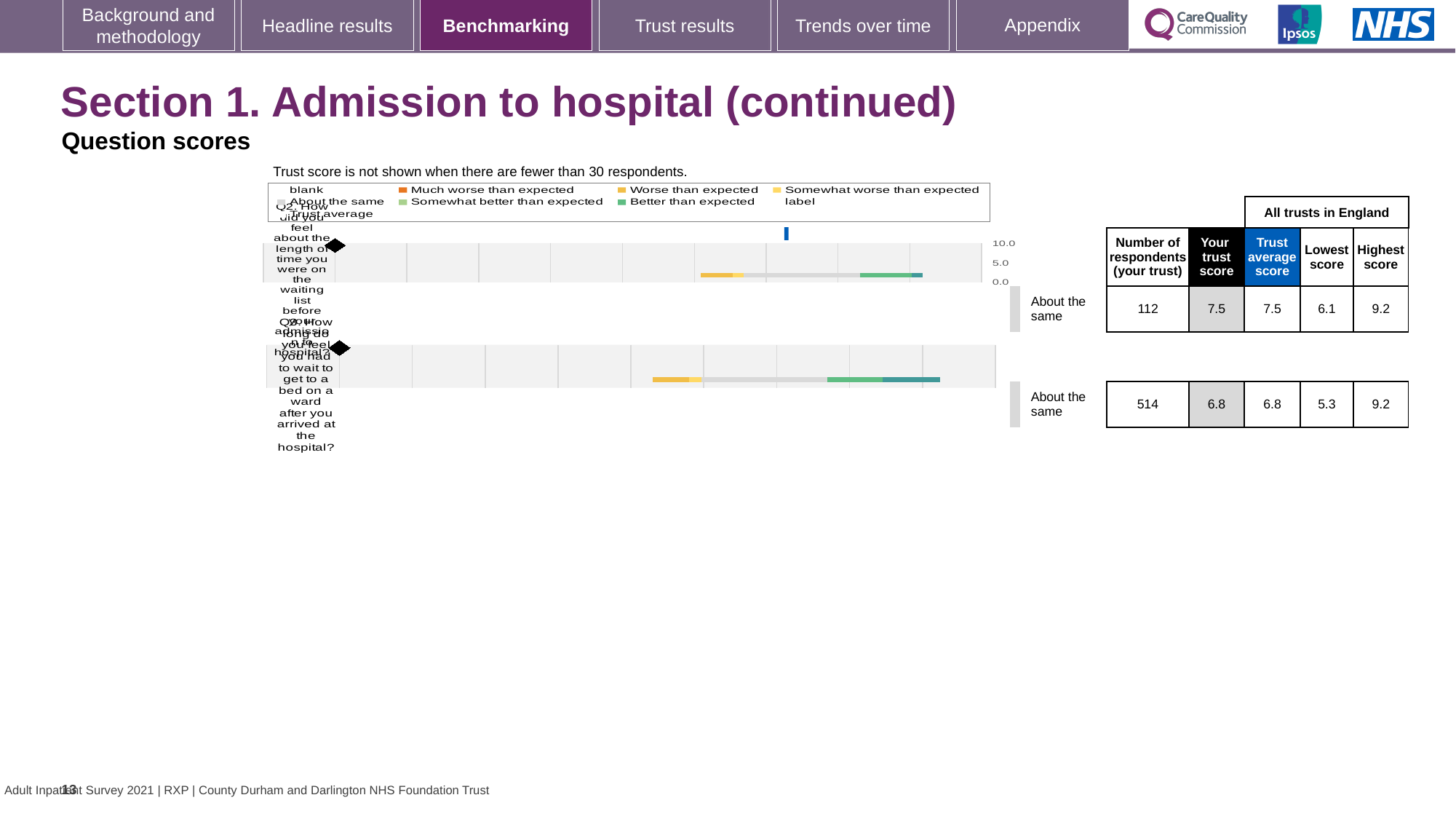
How many respondents answered Q2 for this trust? 112 What is the lowest score across all trusts in England for Q2? 6.1 What kind of chart is used to show the question scores on this slide? bar chart What is the difference between the highest and lowest scores for Q3? 3.9 What is the highest score across all trusts in England for Q3? 9.2 How many respondents answered Q3 for this trust? 514 What benchmark category is shown for Q2? About the same What is the trust score for Q3 (wait to get to a bed on a ward after arriving at the hospital)? 6.8 Which question has the higher trust score, Q2 or Q3? Q2 Is the trust score for Q3 greater or less than 5.0? greater How many questions are plotted in the question scores charts? 2 What is the trust score for Q2 (length of time on the waiting list before admission)? 7.5